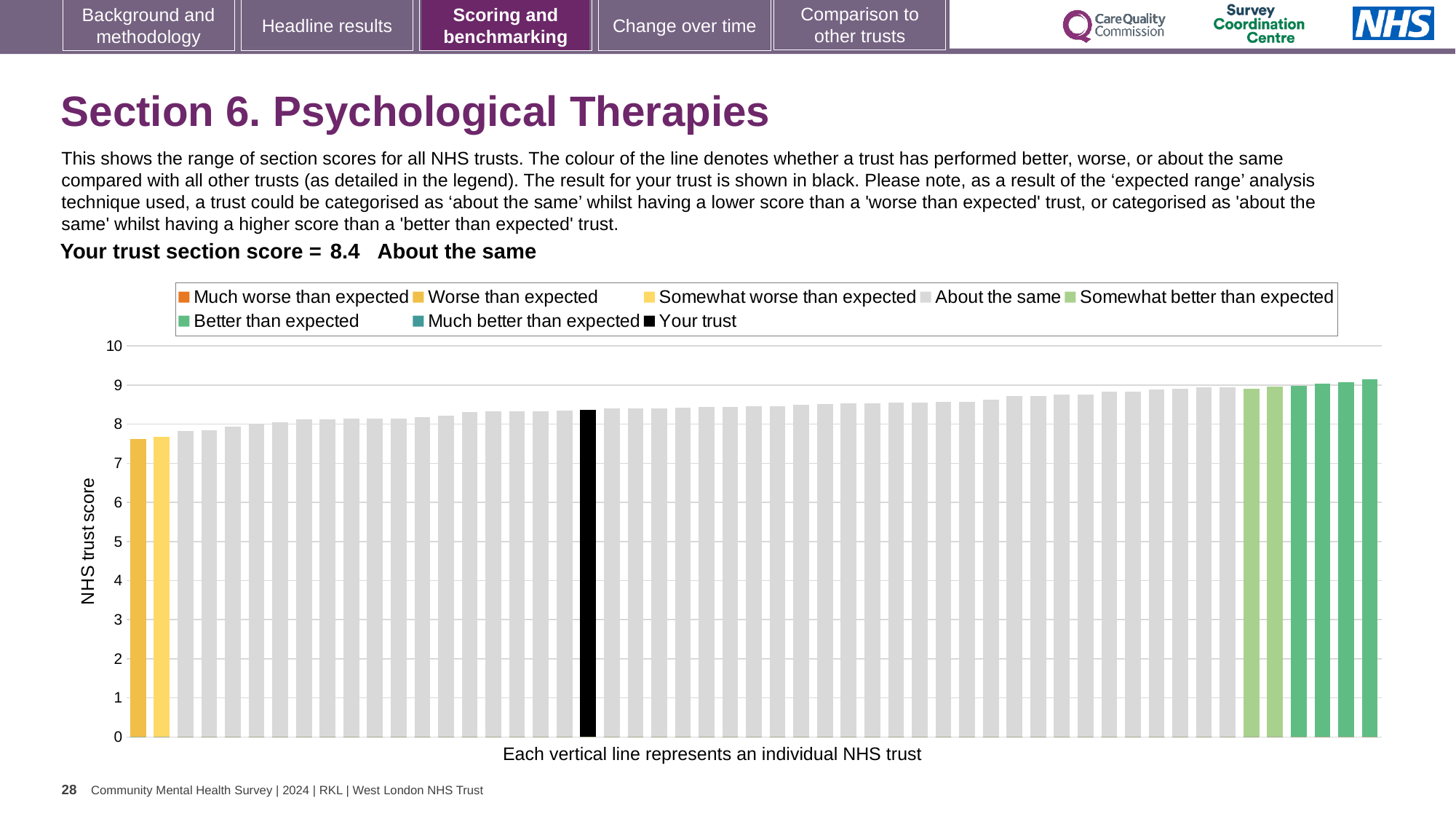
Is the value of the rightmost bar greater or less than 9? greater What is the section score for your trust shown on the slide? 8.4 Is the value for your trust (the black bar) greater or less than 8? greater Which is larger: the value of the black bar (your trust) or the value of the rightmost bar? the rightmost bar How many entries does the chart legend list? 8 Is the value for your trust (the black bar) greater or less than 9? less What category does your trust fall into according to the slide? About the same Do the bar values rise or fall from left to right along the x axis? rise What kind of chart is shown on the slide? bar chart What colour is used for the bar representing your trust? black What is the label on the vertical axis of the chart? NHS trust score